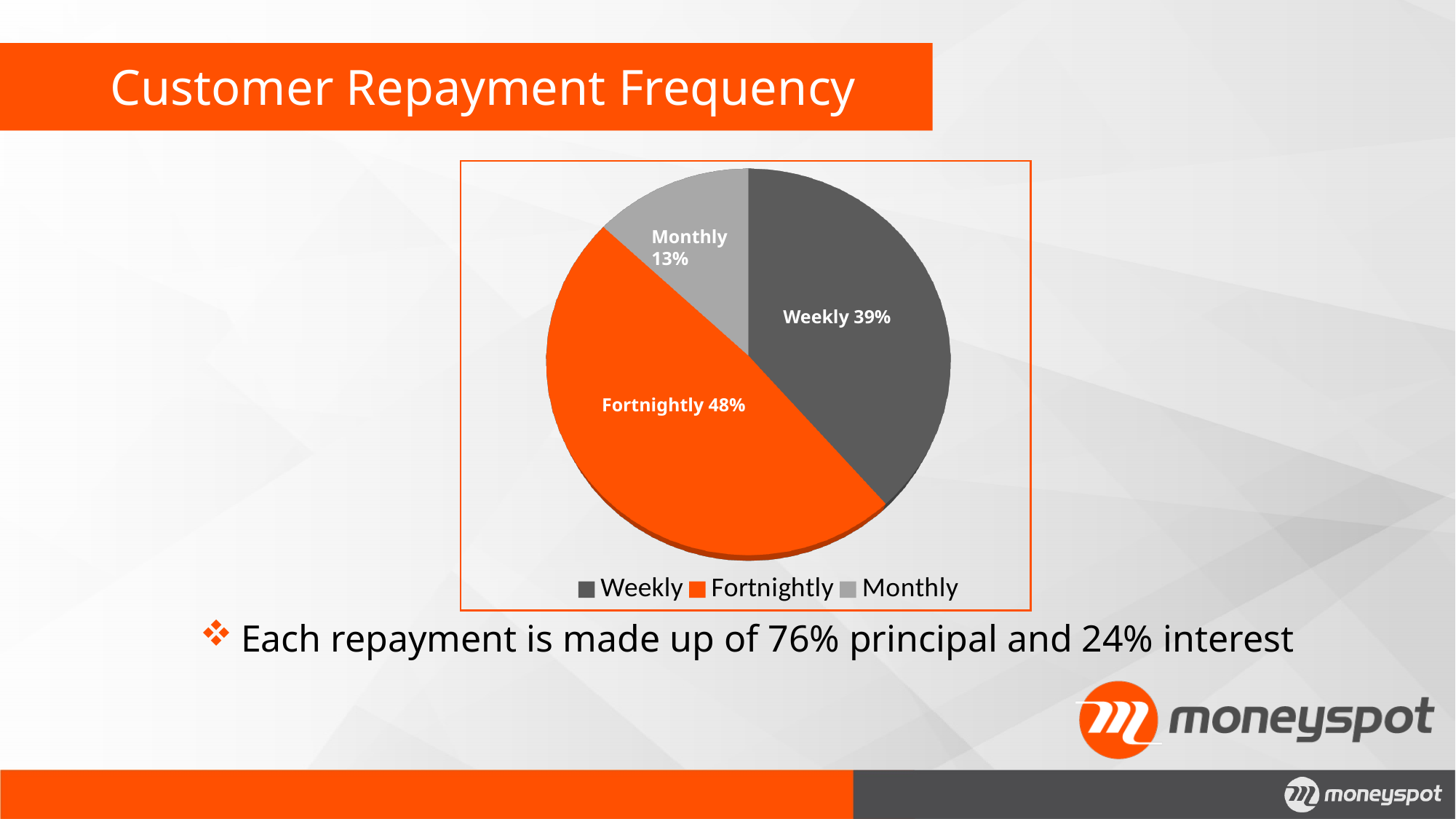
What colour is the Fortnightly slice? orange What share of customers repay fortnightly? 48% Which repayment frequency has the smallest share? Monthly What is the difference in percentage points between the Weekly and Monthly shares? 26 Which is larger, the Weekly share or the Monthly share? Weekly How many slices does the pie chart have? 3 What share of customers repay monthly? 13% What share of customers repay weekly? 39% Which repayment frequency has the largest share? Fortnightly How many entries does the legend list? 3 What kind of chart is shown on the slide? pie chart What is the difference in percentage points between the Fortnightly and Weekly shares? 9